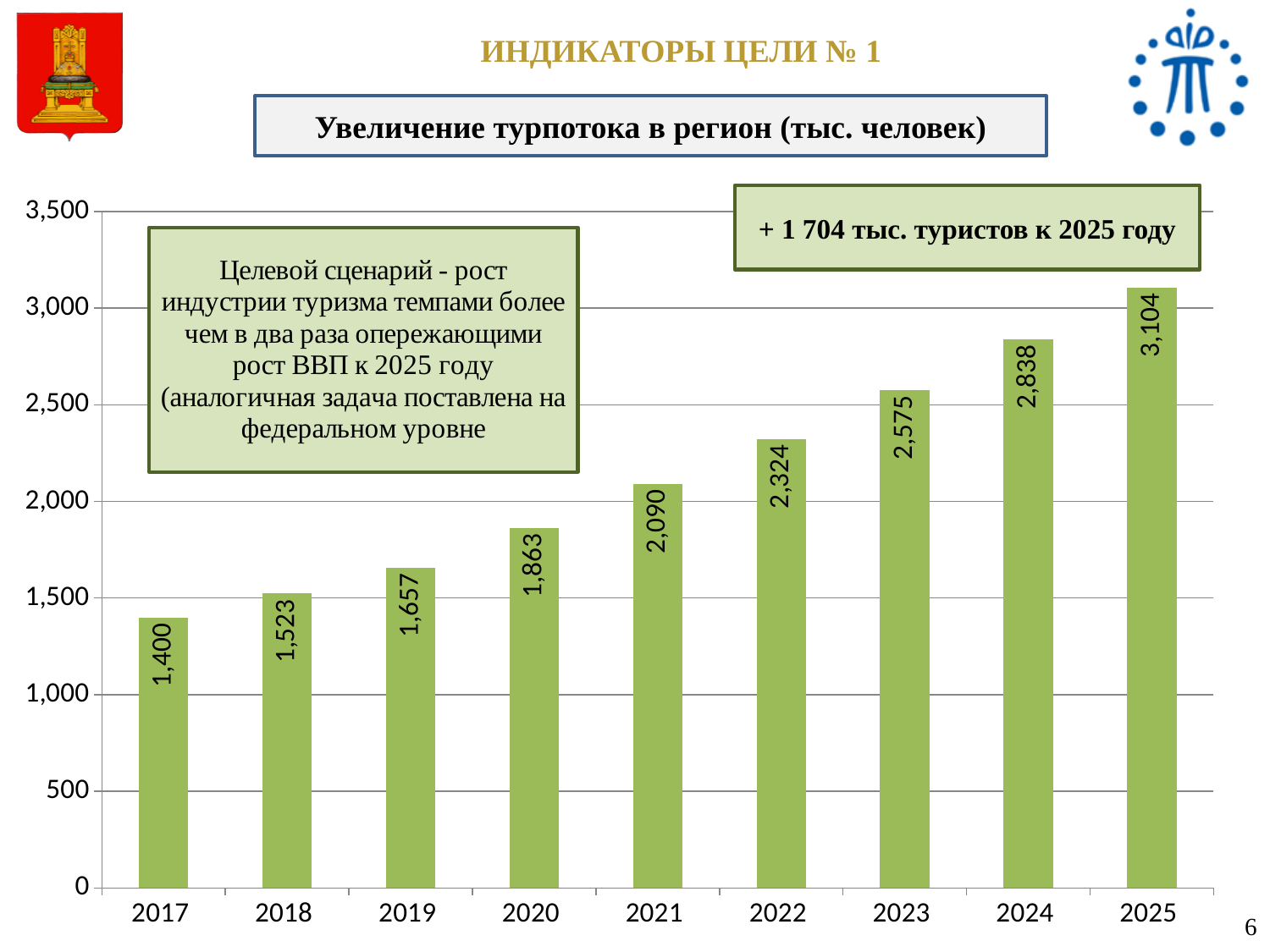
What is the difference between the values for 2023 and 2022? 251 Do the values rise or fall from 2017 to 2025? rise What is the difference between the values for 2025 and 2017? 1,704 How many years are shown on the x axis? 9 What is the value for 2025? 3,104 What kind of chart is shown on the slide? bar chart What is the value for 2017? 1,400 What is the value for 2021? 2,090 Which is larger, the value for 2020 or the value for 2019? 2020 Which year has the lowest value? 2017 Which year has the highest value? 2025 Is the value for 2024 greater or less than 3,000? less